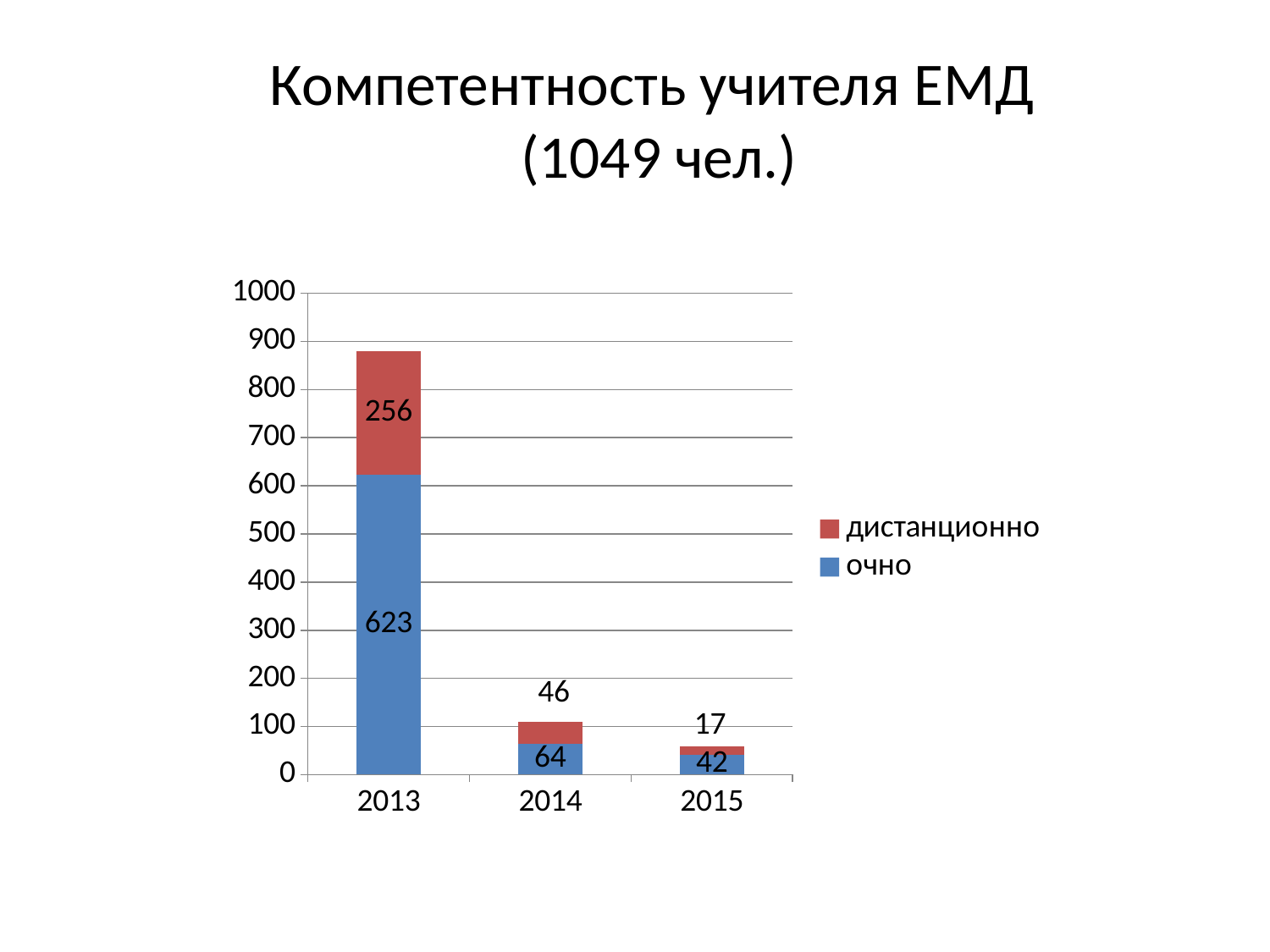
What is the value for дистанционно in 2014? 46 Which is larger in 2014: очно or дистанционно? очно What is the total of the stacked bar for 2013? 879 What is the value for очно in 2013? 623 Which year has the lowest value for дистанционно? 2015 How many years are shown on the x axis? 3 What is the value for дистанционно in 2013? 256 What is the total of the stacked bar for 2015? 59 How many series does the legend list? 2 What is the value for очно in 2015? 42 What is the difference between the очно values for 2013 and 2014? 559 Which year has the highest value for очно? 2013